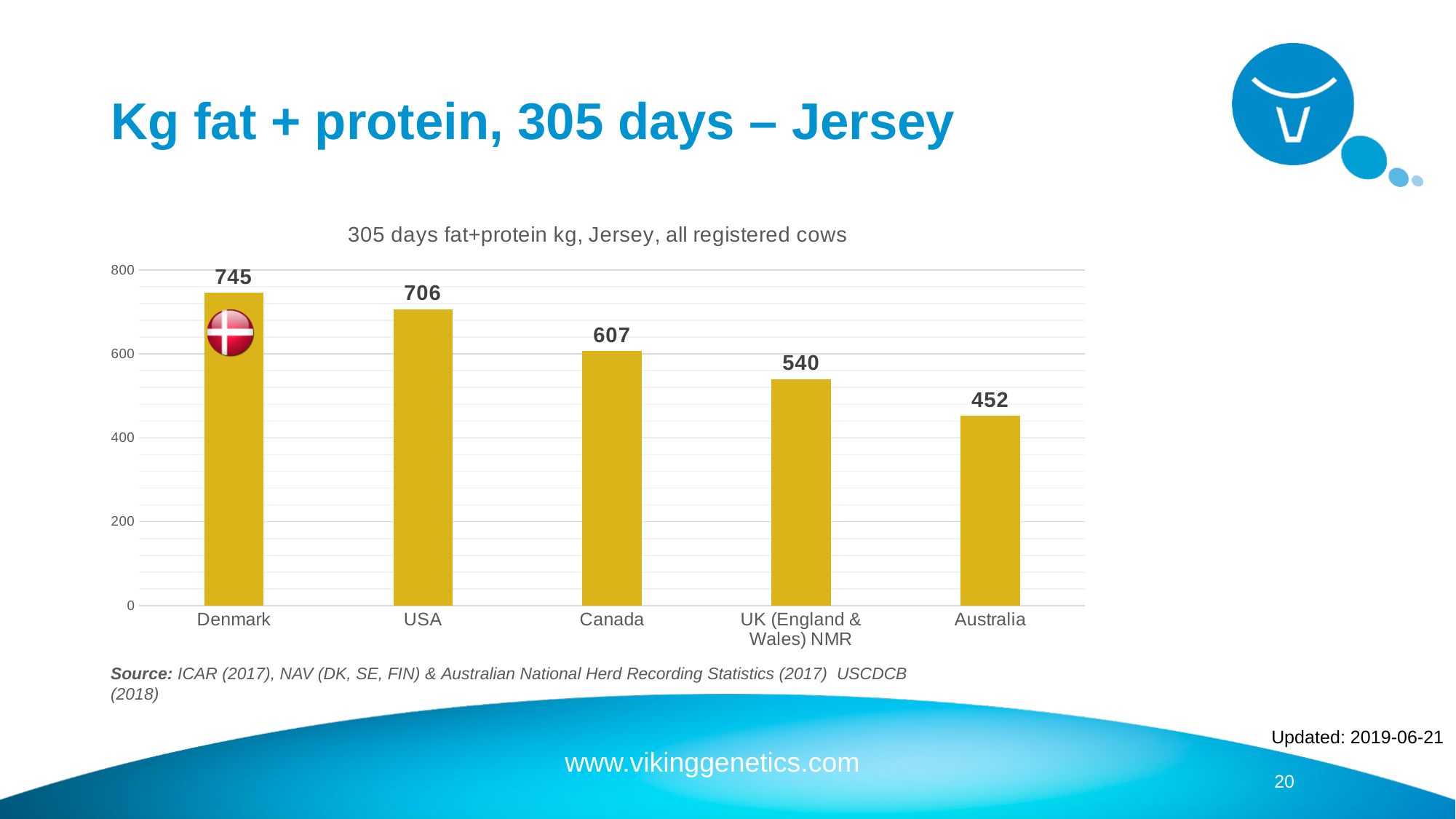
What is the value for Australia? 452 Which country has the lowest value? Australia How many countries are shown in the chart? 5 Which is larger, the value for USA or the value for Canada? USA What is the value for USA? 706 What kind of chart is shown on the slide? Bar chart What is the title of the chart? 305 days fat+protein kg, Jersey, all registered cows What is the value for Denmark? 745 Which country has the highest value? Denmark What is the value for UK (England & Wales) NMR? 540 What is the difference between the values for Denmark and Australia? 293 What is the value for Canada? 607